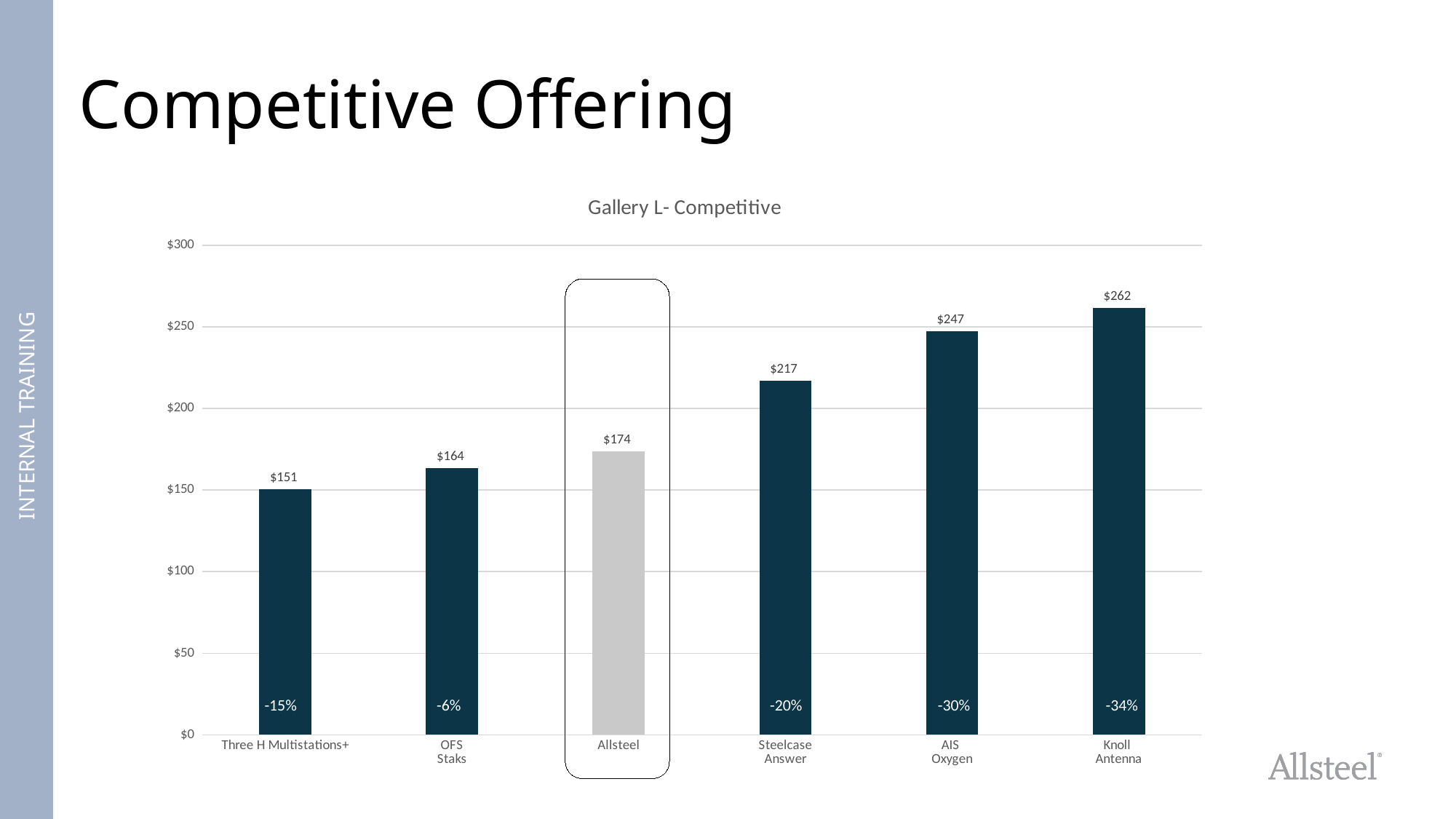
What is the value for Knoll Antenna? $262 Which is larger, the value for Steelcase Answer or the value for OFS Staks? Steelcase Answer What kind of chart is this? bar chart What percentage label is printed on the Knoll Antenna bar? -34% What is the value for OFS Staks? $164 What is the value for Allsteel? $174 Is the value for Three H Multistations+ greater or less than $200? less Which category has the lowest value? Three H Multistations+ Which category has the highest value? Knoll Antenna What is the title of the chart? Gallery L- Competitive How many categories are shown on the x axis? 6 What is the difference between the values for AIS Oxygen and Allsteel? $73